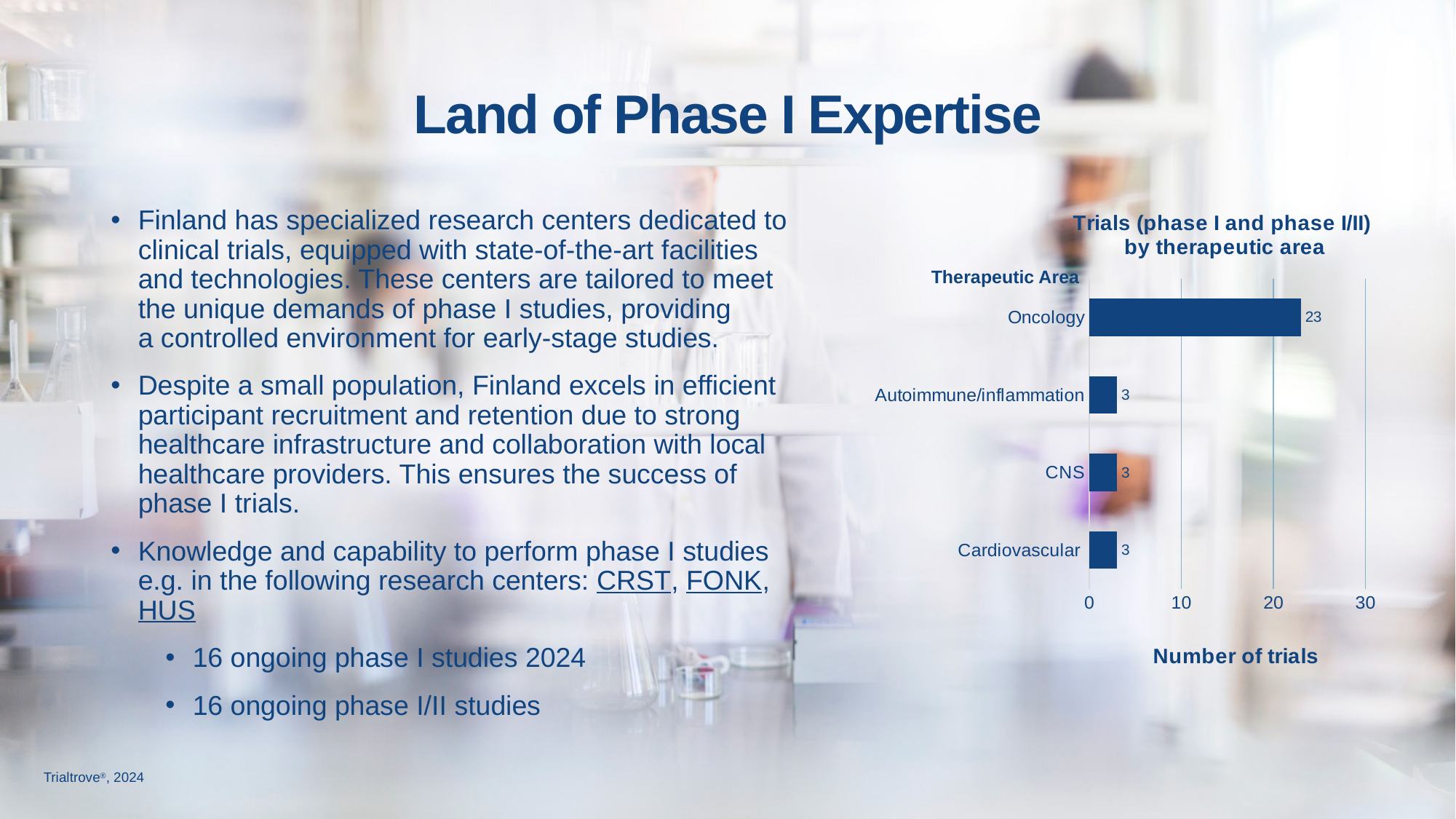
What kind of chart is used to show trials by therapeutic area? Bar chart Is the value for Oncology greater or less than 20? greater How many trials are shown for Cardiovascular? 3 Which therapeutic area has the highest number of trials? Oncology How many trials are shown for Oncology? 23 Which has more trials, Oncology or Cardiovascular? Oncology How many therapeutic areas are shown in the chart? 4 Is the value for Cardiovascular greater or less than 10? less What is the title of the chart? Trials (phase I and phase I/II) by therapeutic area How many trials are shown for Autoimmune/inflammation? 3 What is the difference in number of trials between Oncology and CNS? 20 How many trials are shown for CNS? 3